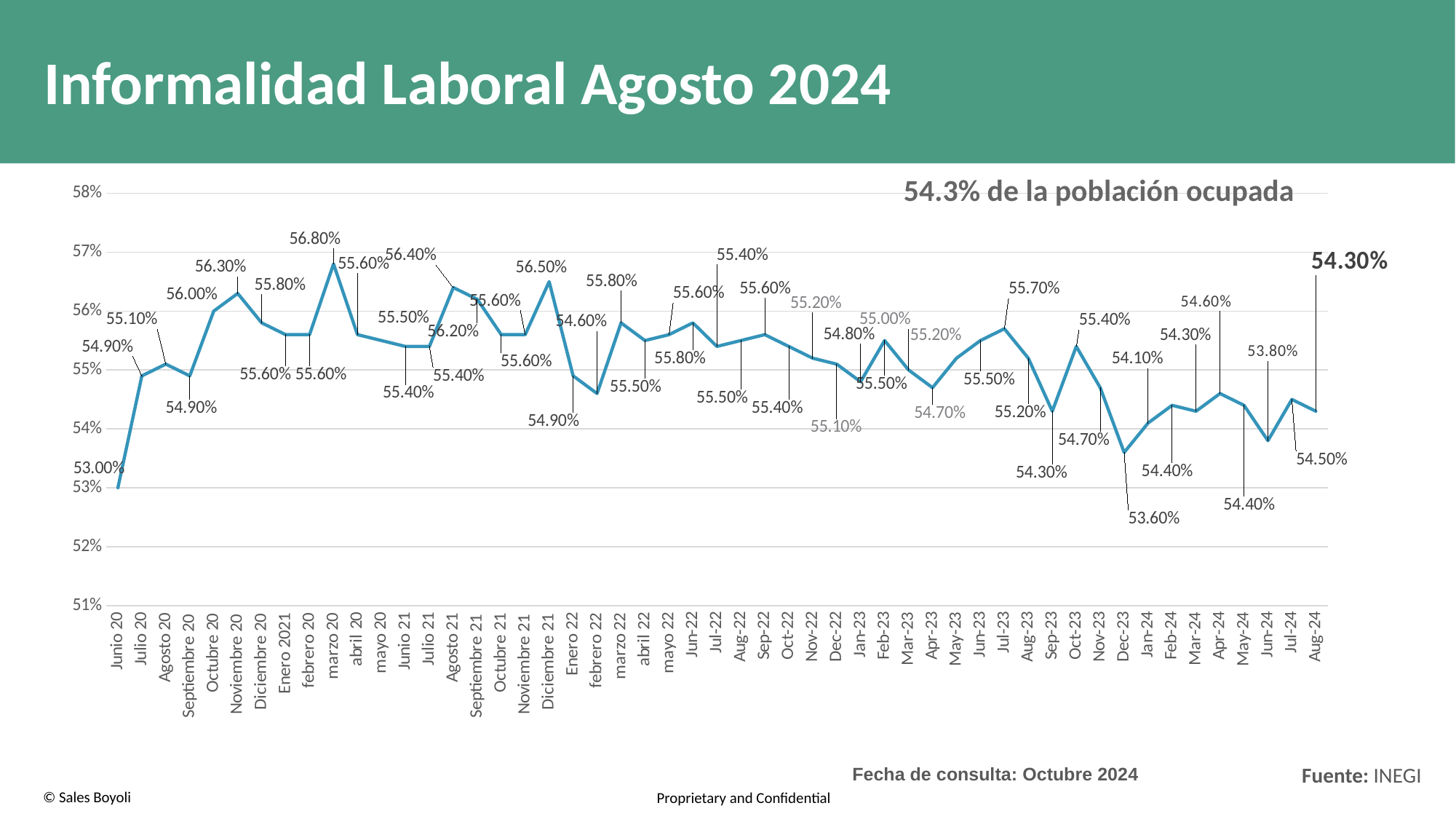
Is the value for Dec-23 greater or less than 54%? less What is the value for Diciembre 21? 56.50% Which month has the lowest value on the chart? Junio 20 Do the values rise or fall from Jul-23 to Dec-23? fall What is the difference between the value for marzo 20 and the value for Junio 20? 3.80 percentage points What is the value for Aug-24? 54.30% What is the value for Junio 20? 53.00% What is the title of the slide? Informalidad Laboral Agosto 2024 Which month has the highest value on the chart? marzo 20 What is the value for Dec-23? 53.60% What kind of chart is shown on the slide? line chart Which is larger, the value for Noviembre 20 or the value for Aug-24? Noviembre 20